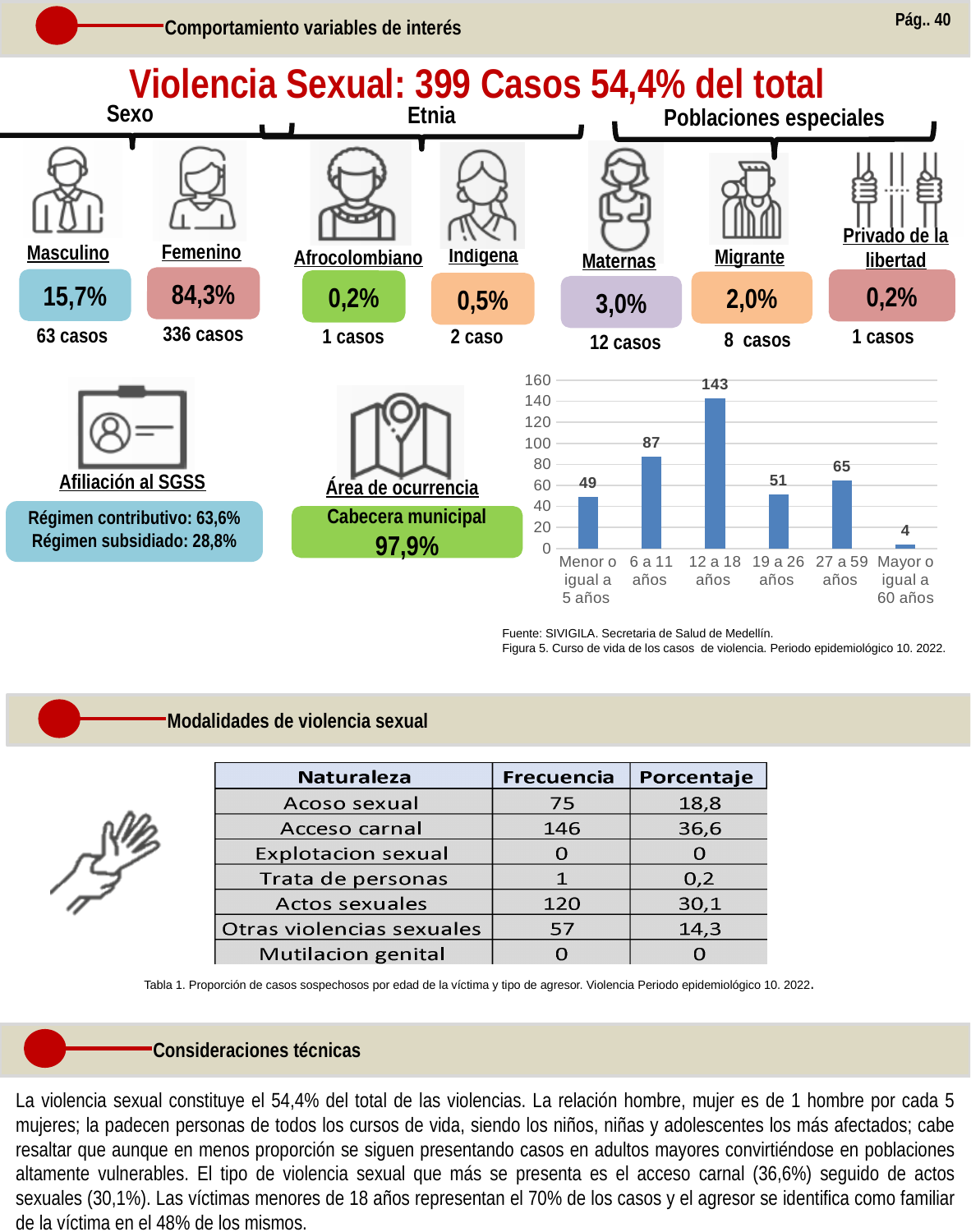
In the bar chart of cases by age group, what is the difference between the values for "12 a 18 años" and "6 a 11 años"? 56 In the bar chart of cases by age group, what is the value for "Menor o igual a 5 años"? 49 In the bar chart of cases by age group, what is the value for "6 a 11 años"? 87 In the bar chart of cases by age group, which age group has the highest value? 12 a 18 años In the bar chart of cases by age group, is the value for "6 a 11 años" greater or less than 80? greater In the bar chart of cases by age group, what is the value for "12 a 18 años"? 143 In the bar chart of cases by age group, what is the difference between the values for "27 a 59 años" and "19 a 26 años"? 14 What type of chart is shown in the bar chart of cases by age group (Figura 5)? bar chart In the bar chart of cases by age group, which is larger: the value for "27 a 59 años" or the value for "19 a 26 años"? 27 a 59 años How many age groups are shown in the bar chart of cases by age group? 6 In the bar chart of cases by age group, which age group has the lowest value? Mayor o igual a 60 años In the bar chart of cases by age group, what is the value for "Mayor o igual a 60 años"? 4